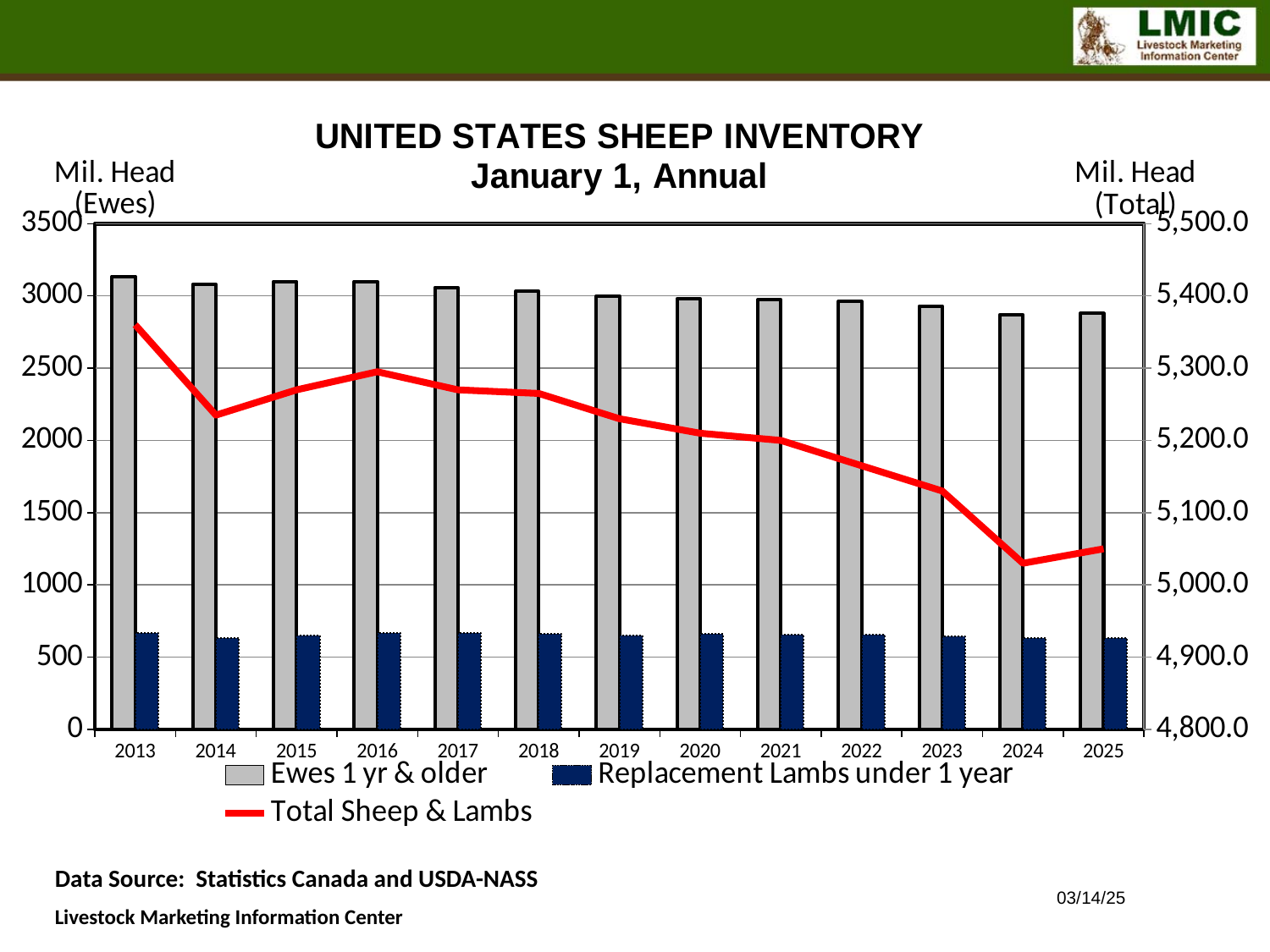
In which year is the Total Sheep & Lambs line at its lowest? 2024 How many series does the chart's legend list? 3 Is the value for Ewes 1 yr & older in 2013 greater or less than 3000? greater What is the title of the chart? UNITED STATES SHEEP INVENTORY January 1, Annual In which year is the Total Sheep & Lambs line at its highest? 2013 Which series is drawn as a red line in the chart? Total Sheep & Lambs What kind of chart is shown on the slide? A combination bar and line chart How many years are shown on the x axis of the chart? 13 Is the value for Total Sheep & Lambs in 2024 greater or less than 5,100.0? less Does the Total Sheep & Lambs line generally rise or fall from 2013 to 2025? fall Is the value for Ewes 1 yr & older in 2024 greater or less than 3000? less Which is larger, the Ewes 1 yr & older value in 2013 or in 2024? 2013